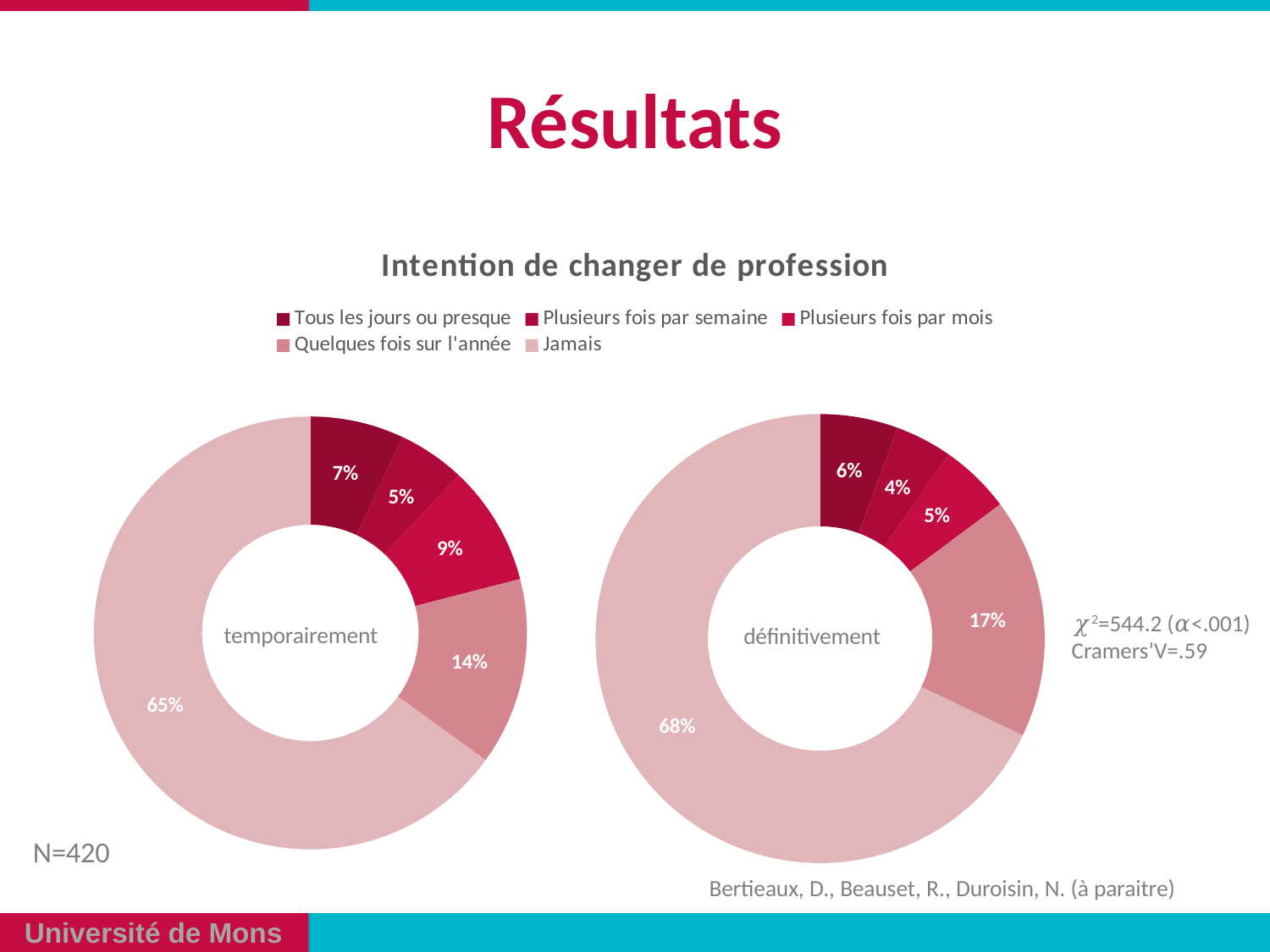
What sample size (N) is shown on the slide? N=420 In the 'définitivement' doughnut chart, which category has the smallest share? Plusieurs fois par semaine How many categories does the legend list for the charts? 5 In the 'définitivement' doughnut chart, what is the share for 'Jamais'? 68% In the 'temporairement' doughnut chart, which category has the largest share? Jamais In the 'temporairement' doughnut chart, what is the share for 'Jamais'? 65% In the 'définitivement' doughnut chart, what is the share for 'Tous les jours ou presque'? 6% What is the difference between the 'Quelques fois sur l'année' shares in the 'définitivement' chart and the 'temporairement' chart? 3 percentage points In the 'temporairement' doughnut chart, what is the share for 'Quelques fois sur l'année'? 14% Which is larger: the 'Plusieurs fois par mois' share in the 'temporairement' chart or in the 'définitivement' chart? temporairement What is the title shown above the two doughnut charts? Intention de changer de profession What type of chart is used to show the 'temporairement' and 'définitivement' data? Doughnut chart